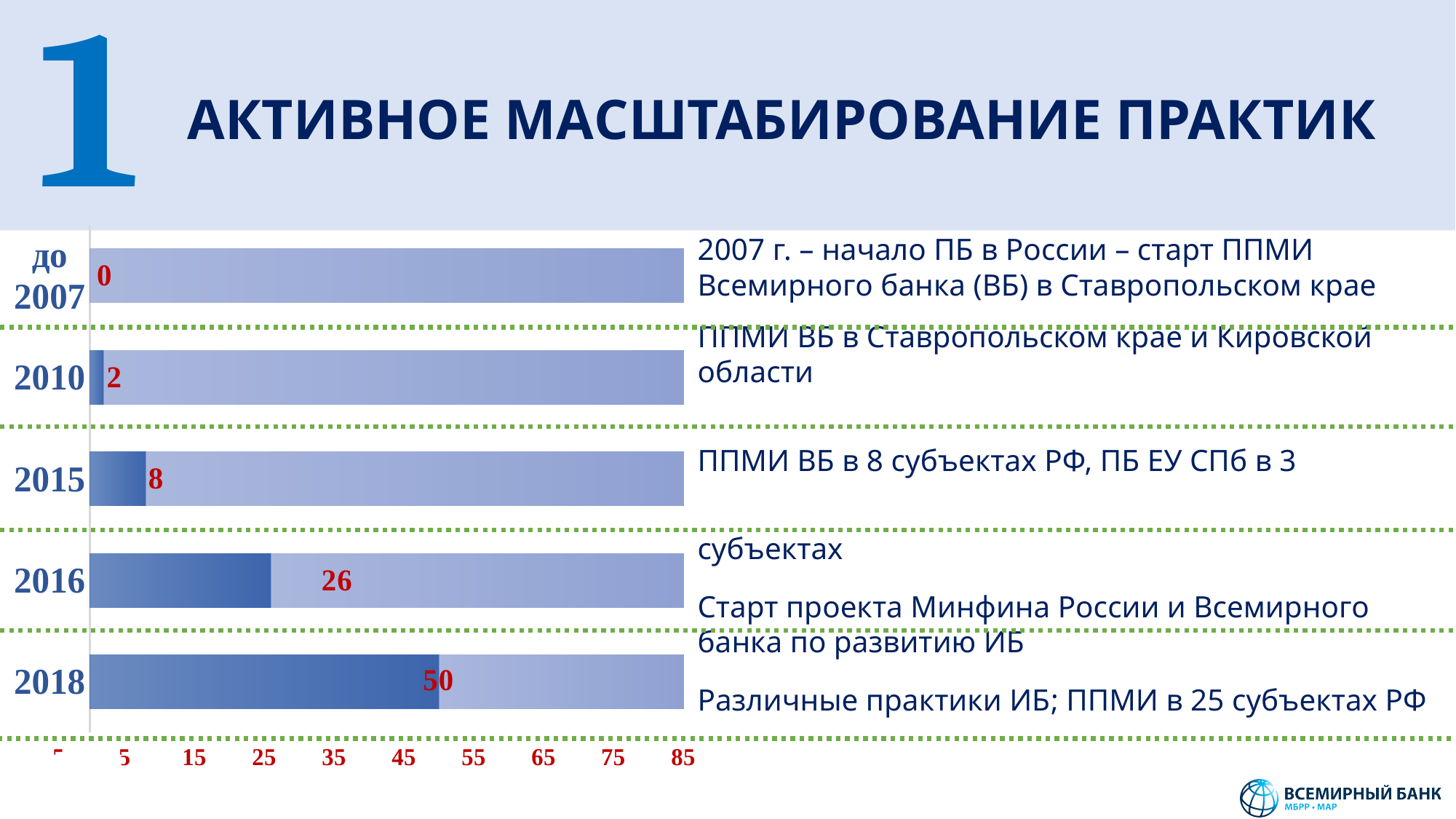
Which category has the highest value? 2018 Do the values rise or fall from до 2007 to 2018? rise Which category has the lowest value? до 2007 What is the value for 2016? 26 What is the value for 2018? 50 What is the value for 2015? 8 Which is larger, the value for 2015 or the value for 2016? 2016 What kind of chart is shown on the slide? bar chart What is the value for 2010? 2 What is the difference between the values for 2018 and 2016? 24 How many categories are shown on the chart? 5 What is the value for до 2007? 0